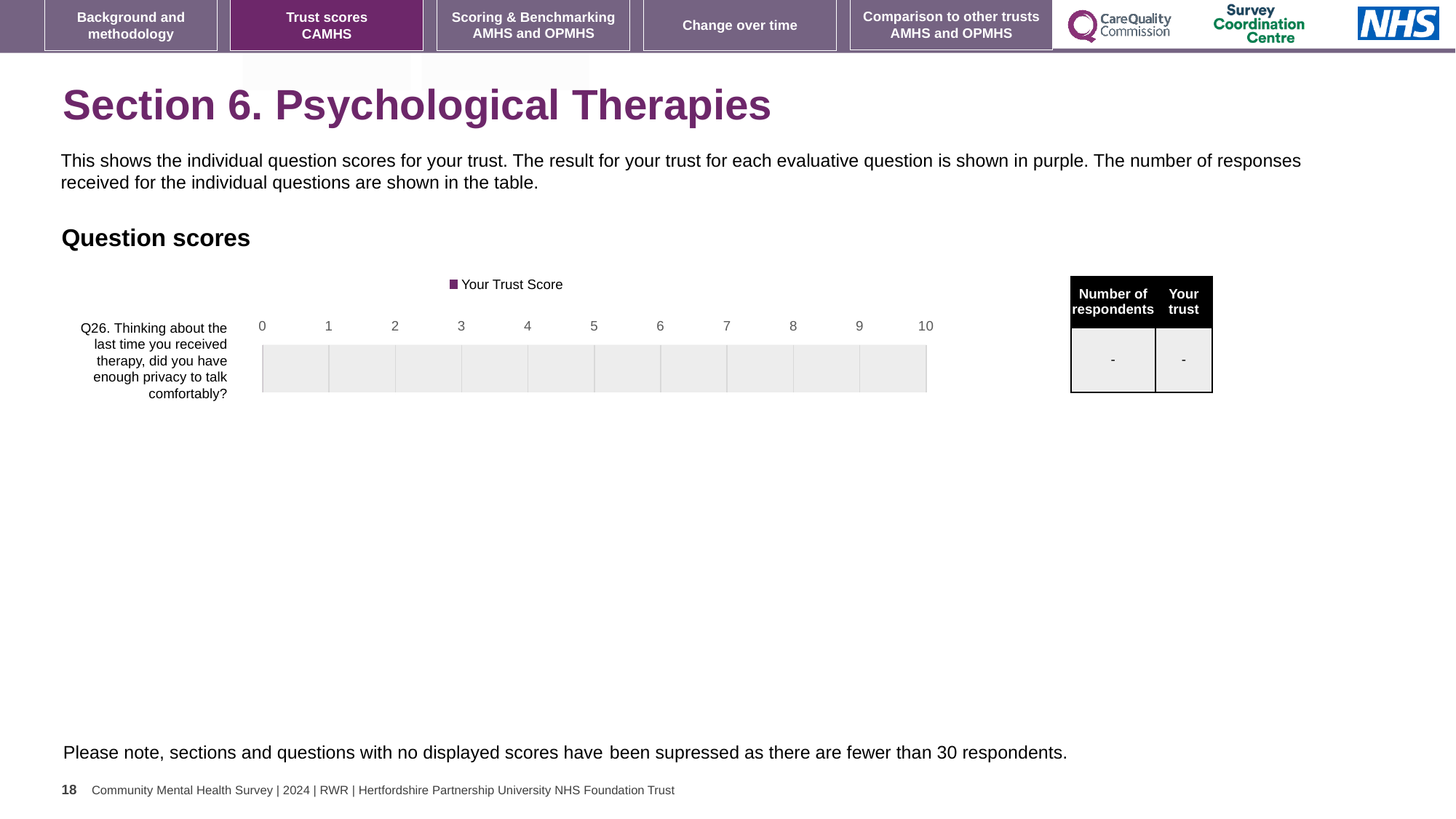
How many series does the legend of the 'Question scores' chart list? 1 What is the name of the series in the legend of the 'Question scores' chart? Your Trust Score How many questions (categories) are plotted on the 'Question scores' chart? 1 Is a bar plotted for Q26 on the 'Question scores' chart? No What value is shown in the 'Your trust' column of the table for Q26? - What kind of chart is shown under 'Question scores'? bar chart What is the highest value shown on the x axis of the 'Question scores' chart? 10 What value is shown in the 'Number of respondents' column of the table for Q26? -